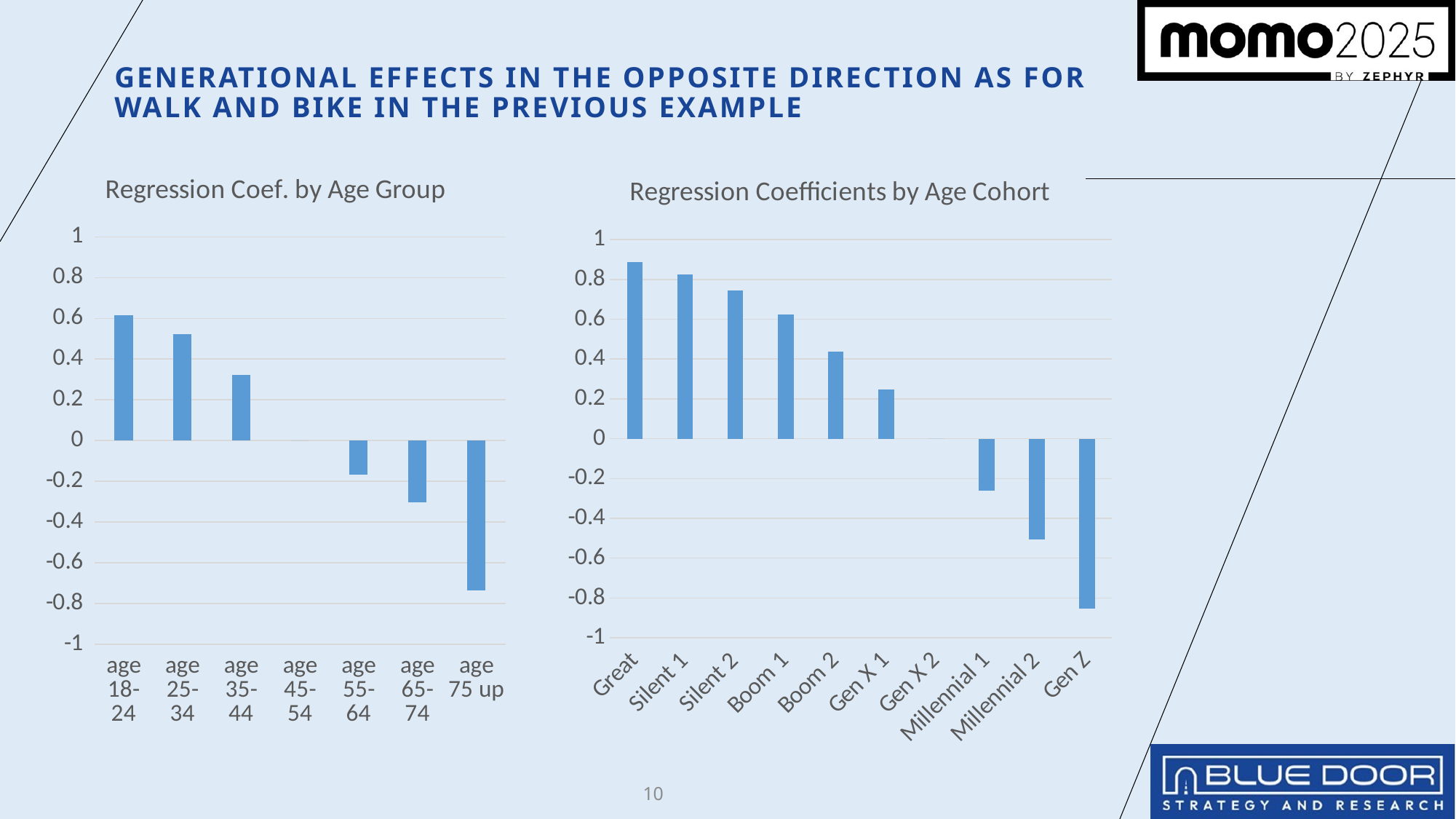
In the chart titled "Regression Coef. by Age Group", is the value for age 18-24 greater or less than 0.4? greater In the chart titled "Regression Coefficients by Age Cohort", which cohort has the lowest regression coefficient? Gen Z In the chart titled "Regression Coefficients by Age Cohort", is the value for Millennial 2 greater or less than -0.2? less In the chart titled "Regression Coef. by Age Group", do the values rise or fall as you move from age 18-24 to age 75 up? fall In the chart titled "Regression Coefficients by Age Cohort", how many cohorts are shown on the x axis? 10 In the chart titled "Regression Coefficients by Age Cohort", which cohort has the highest regression coefficient? Great In the chart titled "Regression Coef. by Age Group", how many age groups are shown on the x axis? 7 In the chart titled "Regression Coefficients by Age Cohort", which is larger, the value for Boom 1 or the value for Gen X 1? Boom 1 In the chart titled "Regression Coef. by Age Group", is the value for age 75 up greater or less than -0.6? less In the chart titled "Regression Coef. by Age Group", which age group has the highest regression coefficient? age 18-24 What kind of chart is the chart titled "Regression Coefficients by Age Cohort"? bar chart In the chart titled "Regression Coef. by Age Group", which age group has the lowest regression coefficient? age 75 up